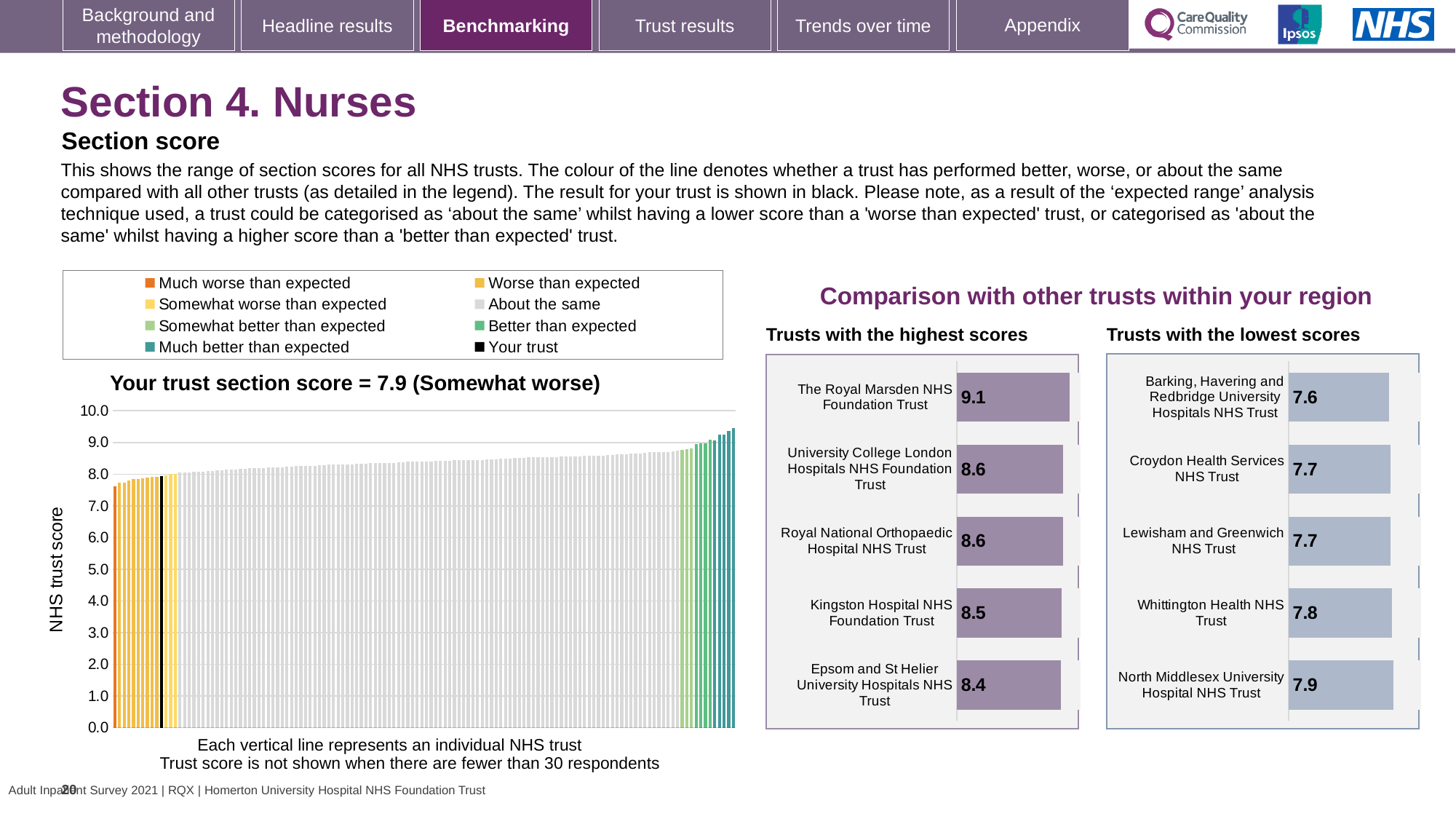
How many trusts are shown in the 'Trusts with the lowest scores' chart? 5 In the 'Trusts with the highest scores' chart, what is the score for Kingston Hospital NHS Foundation Trust? 8.5 In the 'Trusts with the highest scores' chart, what is the score for The Royal Marsden NHS Foundation Trust? 9.1 In the 'Trusts with the highest scores' chart, which trust has the highest score? The Royal Marsden NHS Foundation Trust In the 'Trusts with the highest scores' chart, which has the higher score: Kingston Hospital NHS Foundation Trust or Epsom and St Helier University Hospitals NHS Trust? Kingston Hospital NHS Foundation Trust In the 'Trusts with the highest scores' chart, what is the difference between the scores of The Royal Marsden NHS Foundation Trust and Epsom and St Helier University Hospitals NHS Trust? 0.7 In the main section score chart on the left, what is your trust's section score? 7.9 In the 'Trusts with the lowest scores' chart, which trust has the lowest score? Barking, Havering and Redbridge University Hospitals NHS Trust What kind of chart is the main section score chart on the left? Bar chart In the 'Trusts with the lowest scores' chart, what is the difference between the scores of North Middlesex University Hospital NHS Trust and Barking, Havering and Redbridge University Hospitals NHS Trust? 0.3 In the 'Trusts with the lowest scores' chart, what is the score for Croydon Health Services NHS Trust? 7.7 In the main section score chart on the left, do the values rise or fall from left to right along the x axis? Rise